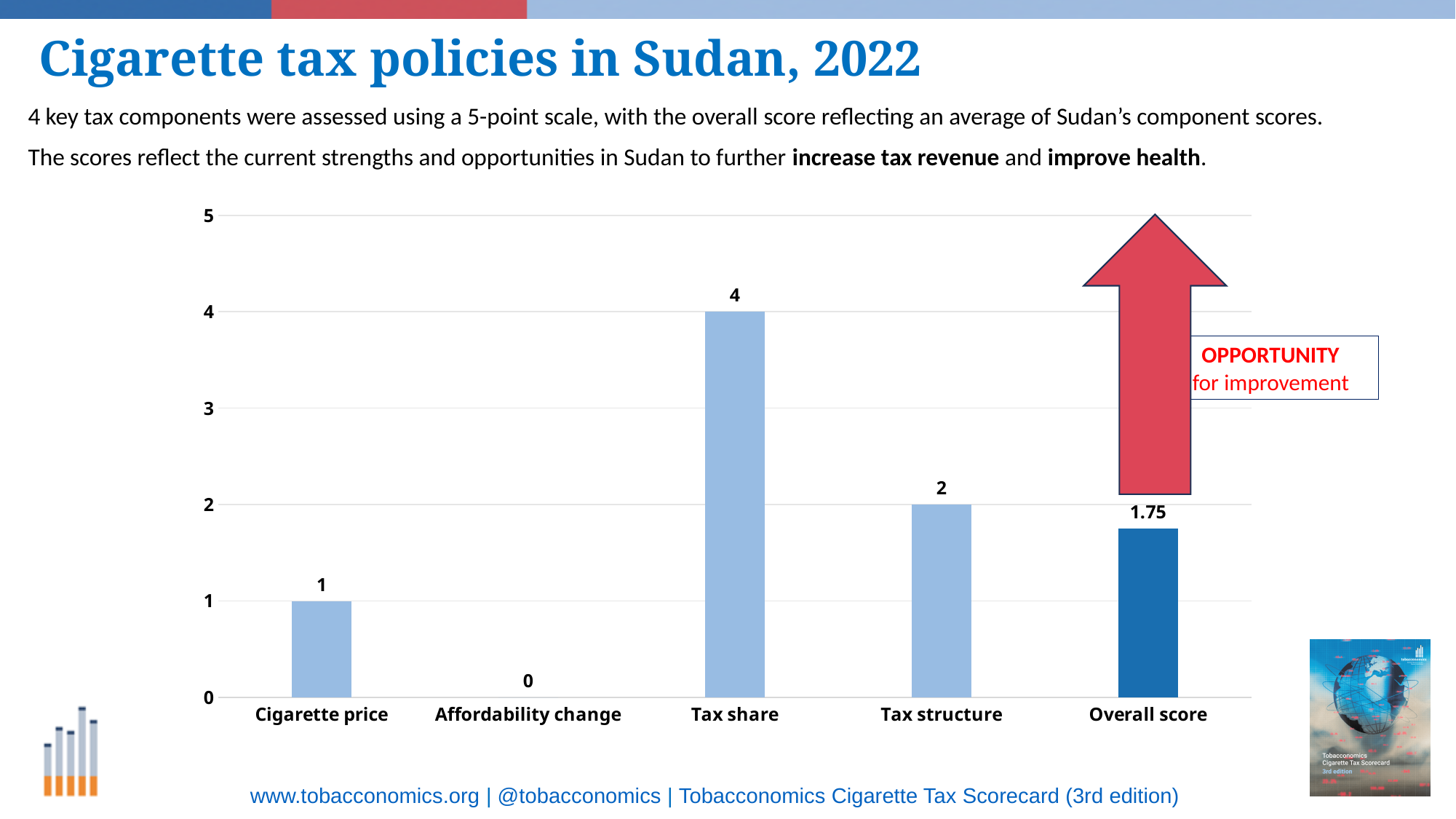
What kind of chart is shown on the slide? bar chart Which is larger, the value for Tax structure or the value for Cigarette price? Tax structure Is the value for Tax share greater or less than 3? greater What is the difference between the values for Tax share and Tax structure? 2 Which category has the highest value? Tax share What is the Overall score? 1.75 Which category has the lowest value? Affordability change What is the maximum value shown on the y axis? 5 What is the value for Tax share? 4 How many categories are shown on the x axis? 5 What is the value for Affordability change? 0 What is the value for Cigarette price? 1